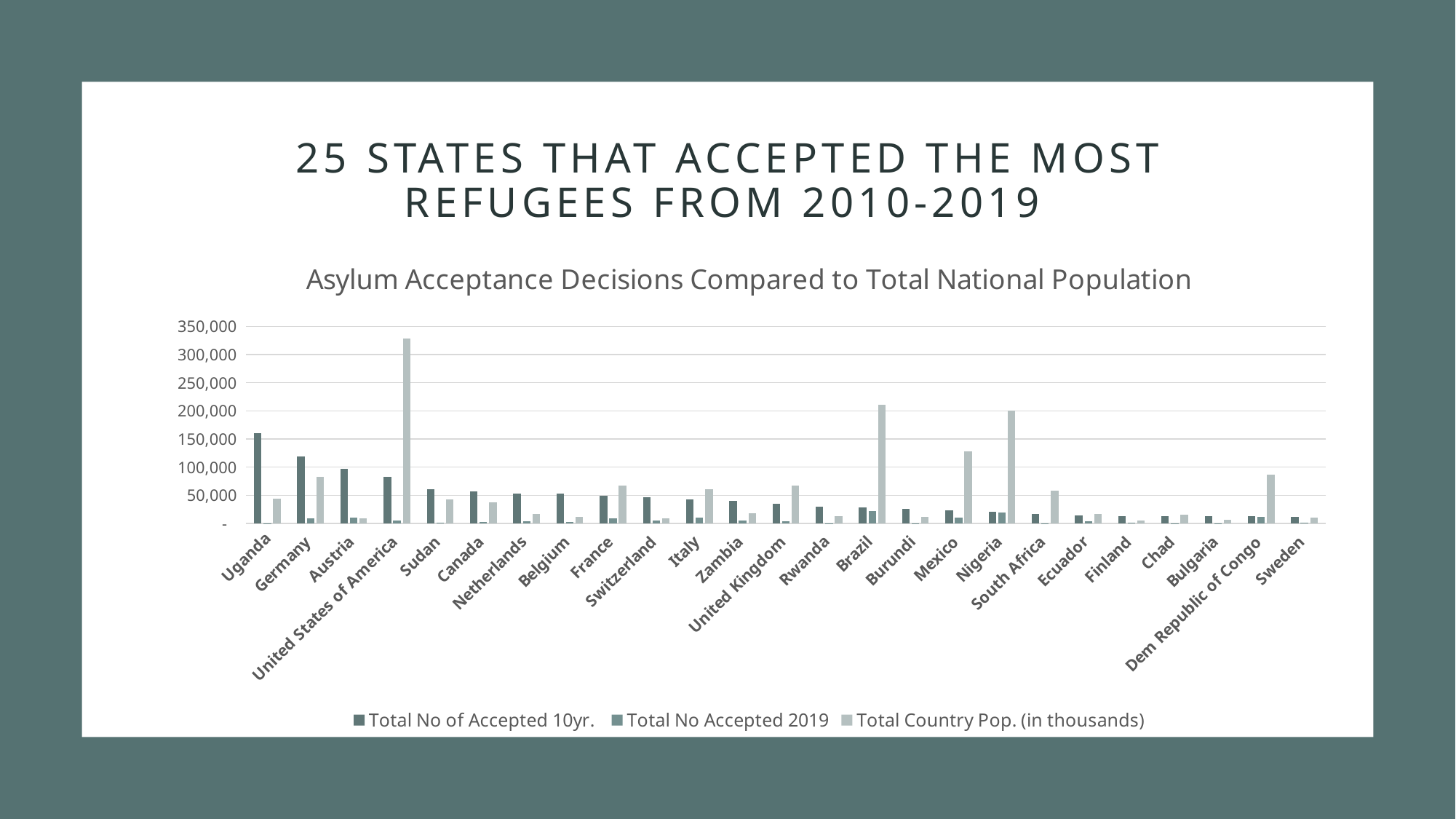
How many countries are shown on the x axis? 25 Which country has the highest value for Total Country Pop. (in thousands)? United States of America Is the Total No of Accepted 10yr. value for Sweden greater or less than 50,000? less Which is larger, the Total No of Accepted 10yr. value for Uganda or for Germany? Uganda How many series does the legend list? 3 Is the Total Country Pop. (in thousands) value for Mexico greater or less than 100,000? greater What kind of chart is shown on the slide? bar chart Is the Total No of Accepted 10yr. value for Germany greater or less than 100,000? greater Do the Total No of Accepted 10yr. values generally rise or fall from left to right along the x axis? fall Which is larger, the Total Country Pop. (in thousands) value for Brazil or for Mexico? Brazil Which country has the highest value for Total No of Accepted 10yr.? Uganda